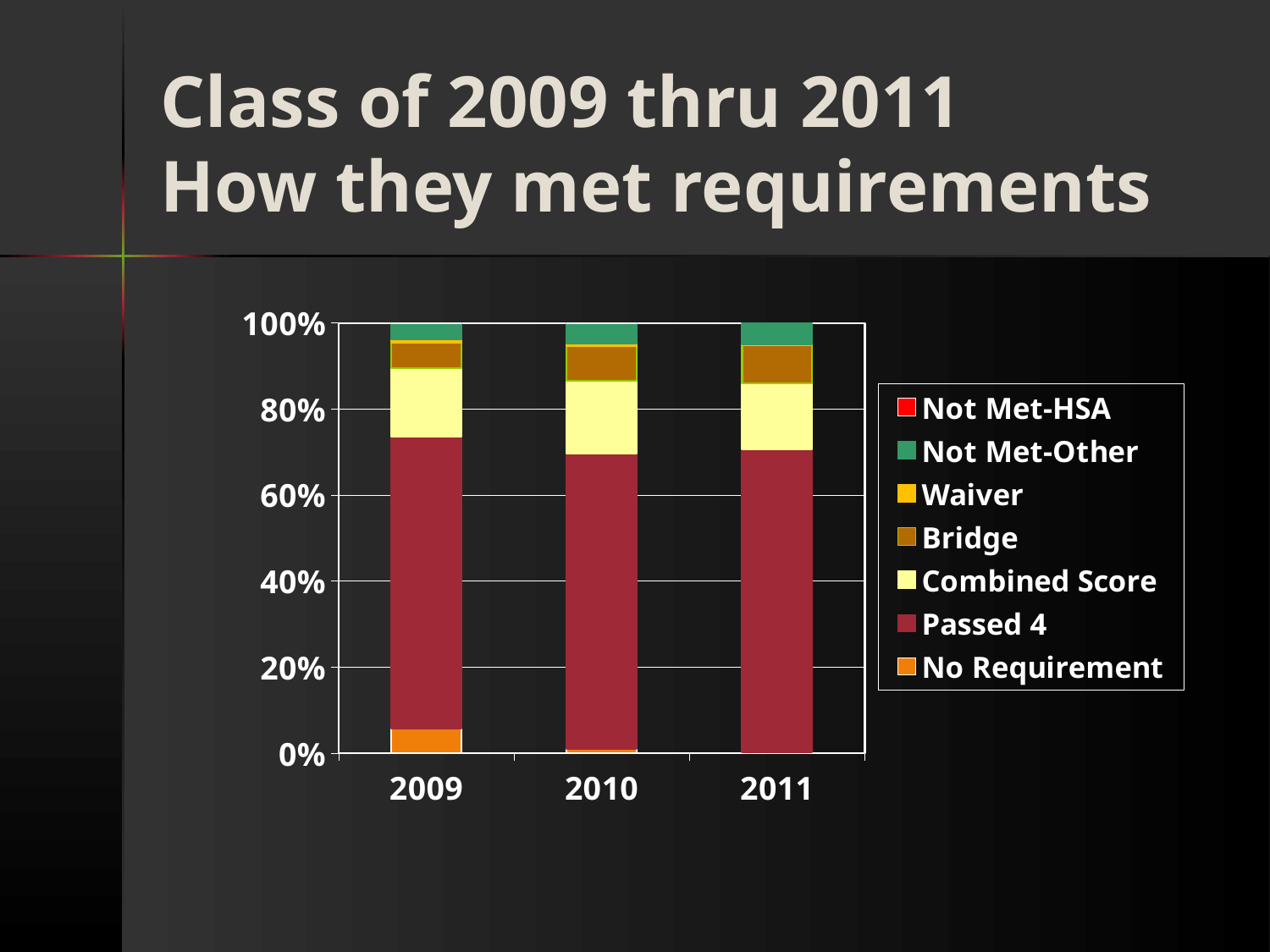
Is the value for No Requirement in 2009 greater or less than 20%? less Is the value for Bridge in 2010 greater or less than 20%? less What is the total height of the 2009 stacked bar? 100% How many series does the legend list? 7 What kind of chart is shown on the slide? Stacked bar chart Which series is shown in dark red? Passed 4 Which legend entry is listed first? Not Met-HSA Which year has the larger No Requirement segment, 2009 or 2010? 2009 How many classes (years) are shown on the x axis? 3 Does the No Requirement segment rise or fall from 2009 to 2011? Fall Is the value for Passed 4 in 2009 greater or less than 60%? greater